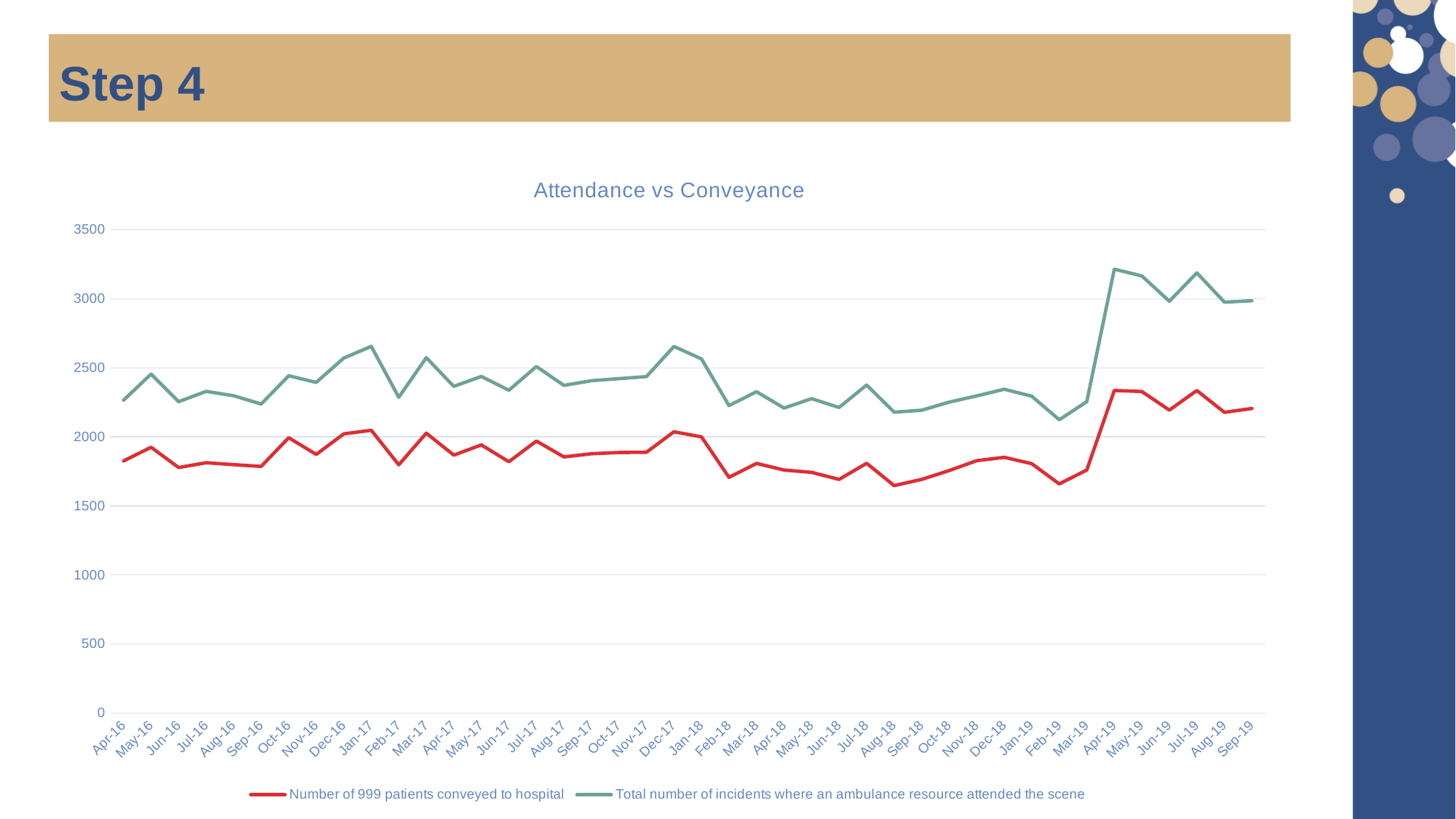
Which series is drawn in red? Number of 999 patients conveyed to hospital Is the value for the total number of incidents where an ambulance resource attended the scene in Feb-19 greater or less than 2500? less Between Mar-19 and Apr-19, do the values for the total number of incidents where an ambulance resource attended the scene rise or fall? rise Is the value for the total number of incidents where an ambulance resource attended the scene in Apr-19 greater or less than 3000? greater Is the value for the number of 999 patients conveyed to hospital in Apr-16 greater or less than 2000? less In Sep-19, which series has the larger value: the number of 999 patients conveyed to hospital or the total number of incidents where an ambulance resource attended the scene? Total number of incidents where an ambulance resource attended the scene How many series does the legend list? 2 What kind of chart is shown on the slide? line chart In which month does the total number of incidents where an ambulance resource attended the scene reach its highest value? Apr-19 What is the title of the chart? Attendance vs Conveyance How many months are plotted along the x axis? 42